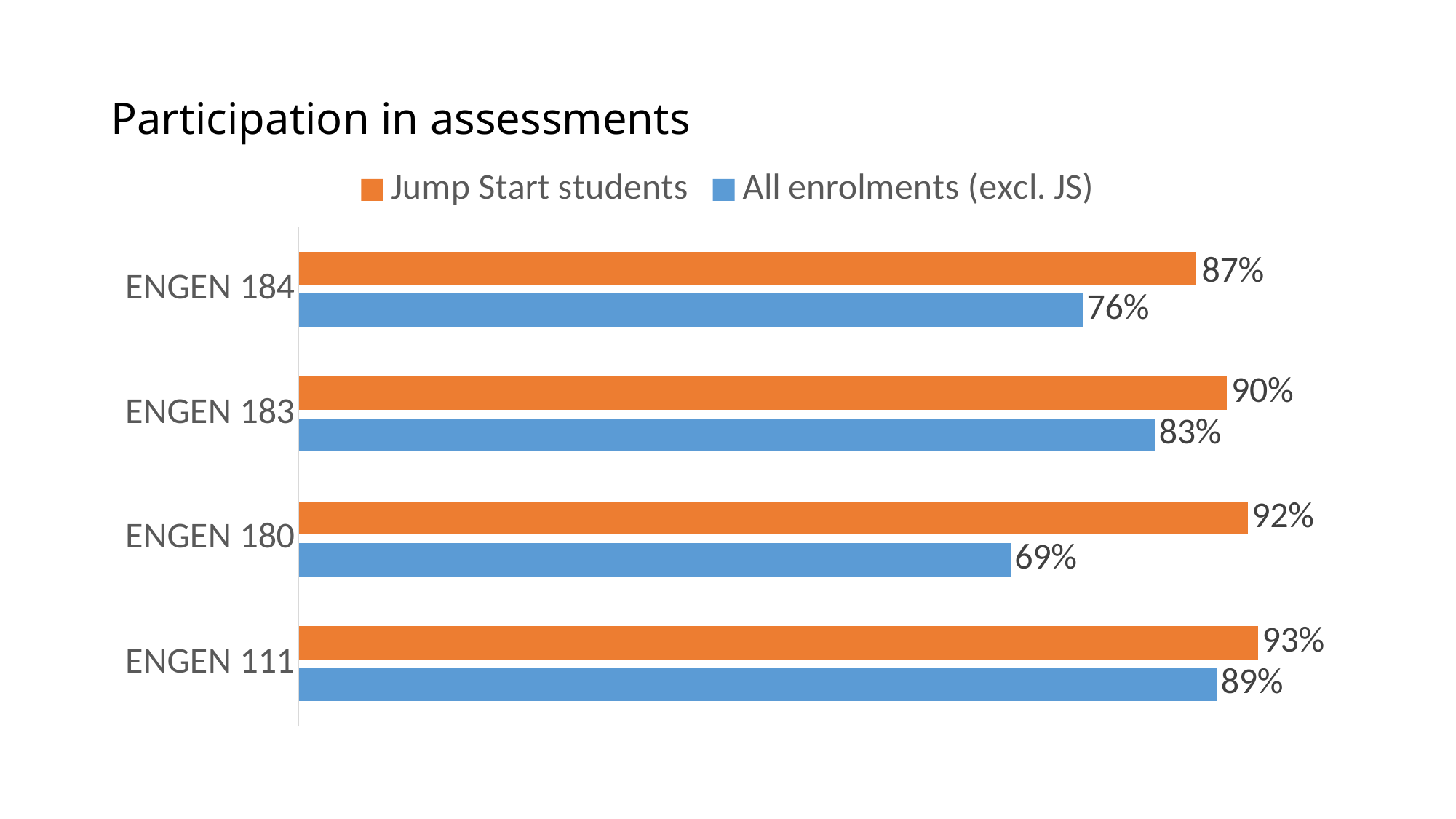
What is the title of the chart? Participation in assessments How many courses are shown on the chart? 4 What is the participation rate for All enrolments (excl. JS) in ENGEN 180? 69% Which course has the lowest participation rate for All enrolments (excl. JS)? ENGEN 180 What is the participation rate for All enrolments (excl. JS) in ENGEN 111? 89% Which course has the highest participation rate for Jump Start students? ENGEN 111 What kind of chart is shown on the slide? Bar chart What is the difference between the Jump Start students and All enrolments (excl. JS) participation rates for ENGEN 180? 23% How many series does the legend list? 2 Which is larger for ENGEN 184: the Jump Start students rate or the All enrolments (excl. JS) rate? Jump Start students What is the difference between the Jump Start students and All enrolments (excl. JS) participation rates for ENGEN 183? 7% What is the participation rate for Jump Start students in ENGEN 184? 87%